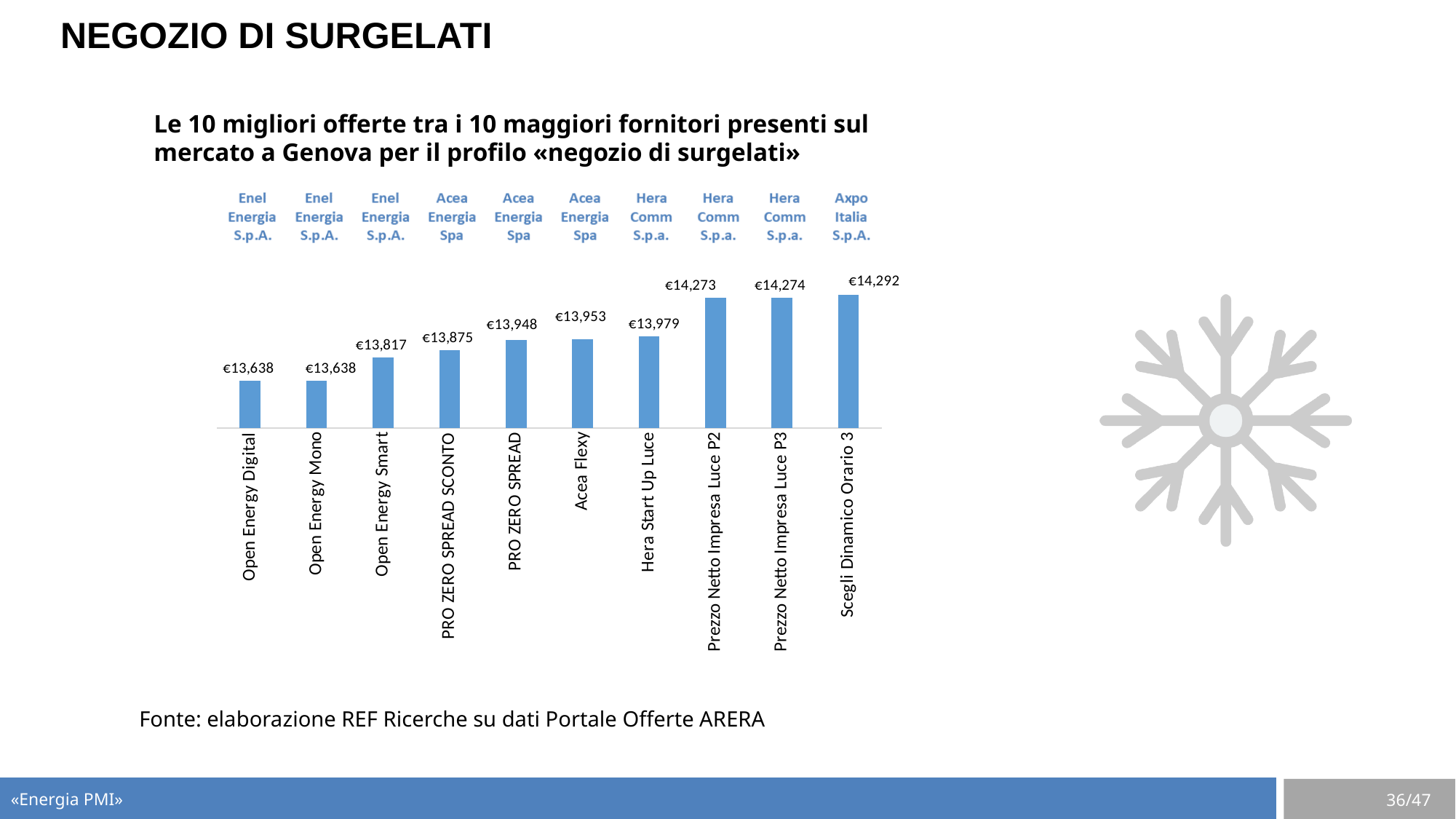
What is the lowest value shown in the chart? €13,638 What is the value for Hera Start Up Luce? €13,979 Do the values rise or fall from left to right across the chart? Rise Which offer has the highest value? Scegli Dinamico Orario 3 What is the difference between the values for Hera Start Up Luce and Acea Flexy? €26 What is the value for Open Energy Smart? €13,817 Which is larger, the value for Open Energy Smart or the value for Hera Start Up Luce? Hera Start Up Luce How many offers are shown in the chart? 10 What kind of chart is shown on the slide? Bar chart What is the difference between the values for Scegli Dinamico Orario 3 and Open Energy Digital? €654 What is the value for Prezzo Netto Impresa Luce P2? €14,273 Which supplier is listed above the bar for Scegli Dinamico Orario 3? Axpo Italia S.p.A.